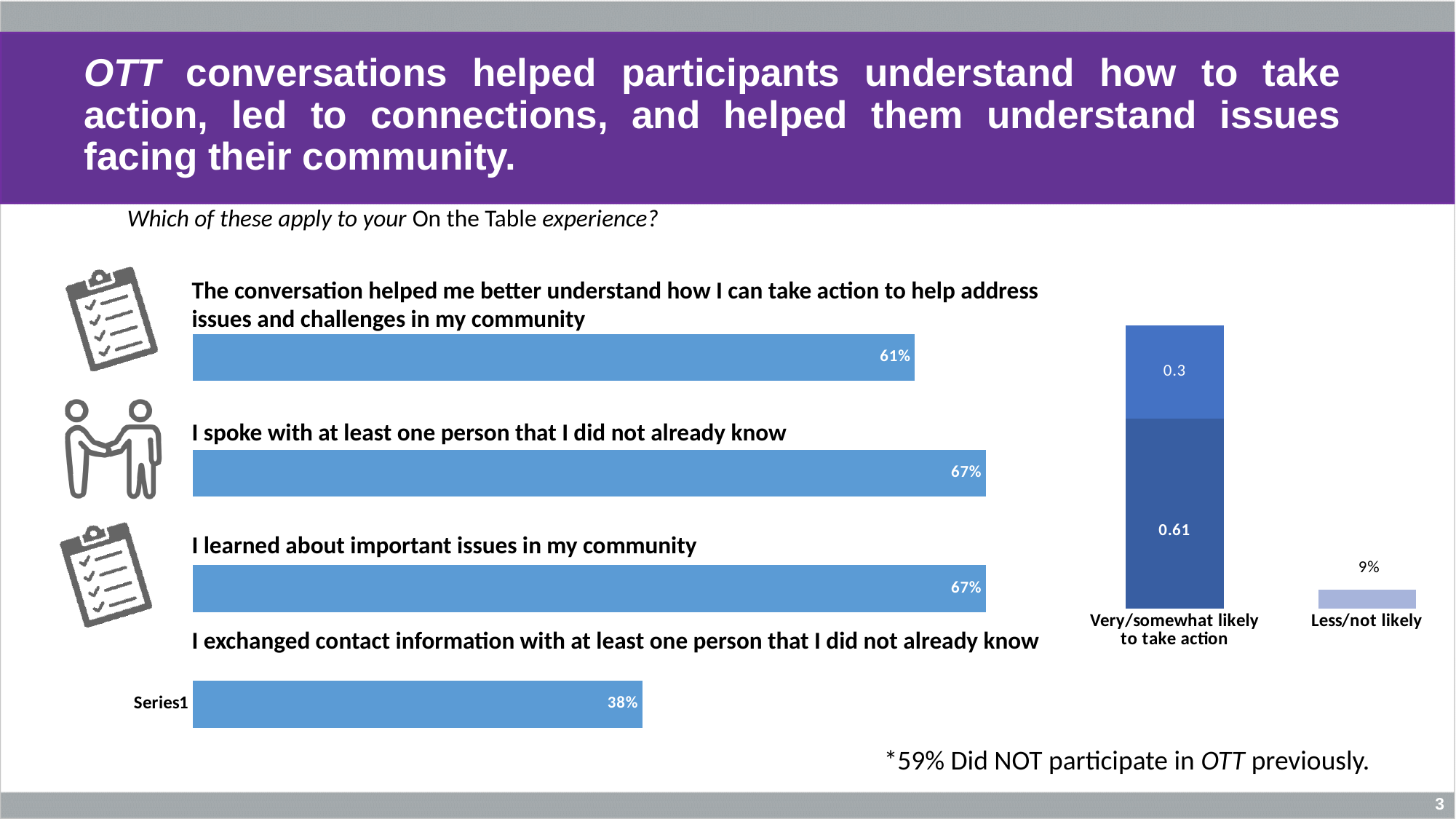
In the horizontal bar chart on the left, what percentage of participants said they exchanged contact information with at least one person they did not already know? 38% In the stacked bar chart on the right, what is the value shown for 'Less/not likely'? 9% In the horizontal bar chart on the left, what percentage of participants said the conversation helped them better understand how they can take action to help address issues and challenges in their community? 61% In the stacked bar chart on the right, what is the value of the upper (lighter blue) segment of the 'Very/somewhat likely to take action' bar? 0.3 In the horizontal bar chart on the left, what is the difference between the percentage who spoke with at least one person they did not already know and the percentage who exchanged contact information with someone they did not already know? 29% What kind of chart is the chart on the left of the slide? Bar chart In the horizontal bar chart on the left, which is larger: the percentage who learned about important issues in their community or the percentage who said the conversation helped them understand how to take action? I learned about important issues in my community How many bars are in the horizontal bar chart on the left? 4 In the horizontal bar chart on the left, what percentage of participants said they spoke with at least one person they did not already know? 67% In the stacked bar chart on the right, what is the value of the lower (dark blue) segment of the 'Very/somewhat likely to take action' bar? 0.61 In the stacked bar chart on the right, what is the total of the 'Very/somewhat likely to take action' bar? 0.91 In the horizontal bar chart on the left, which statement has the lowest percentage? I exchanged contact information with at least one person that I did not already know